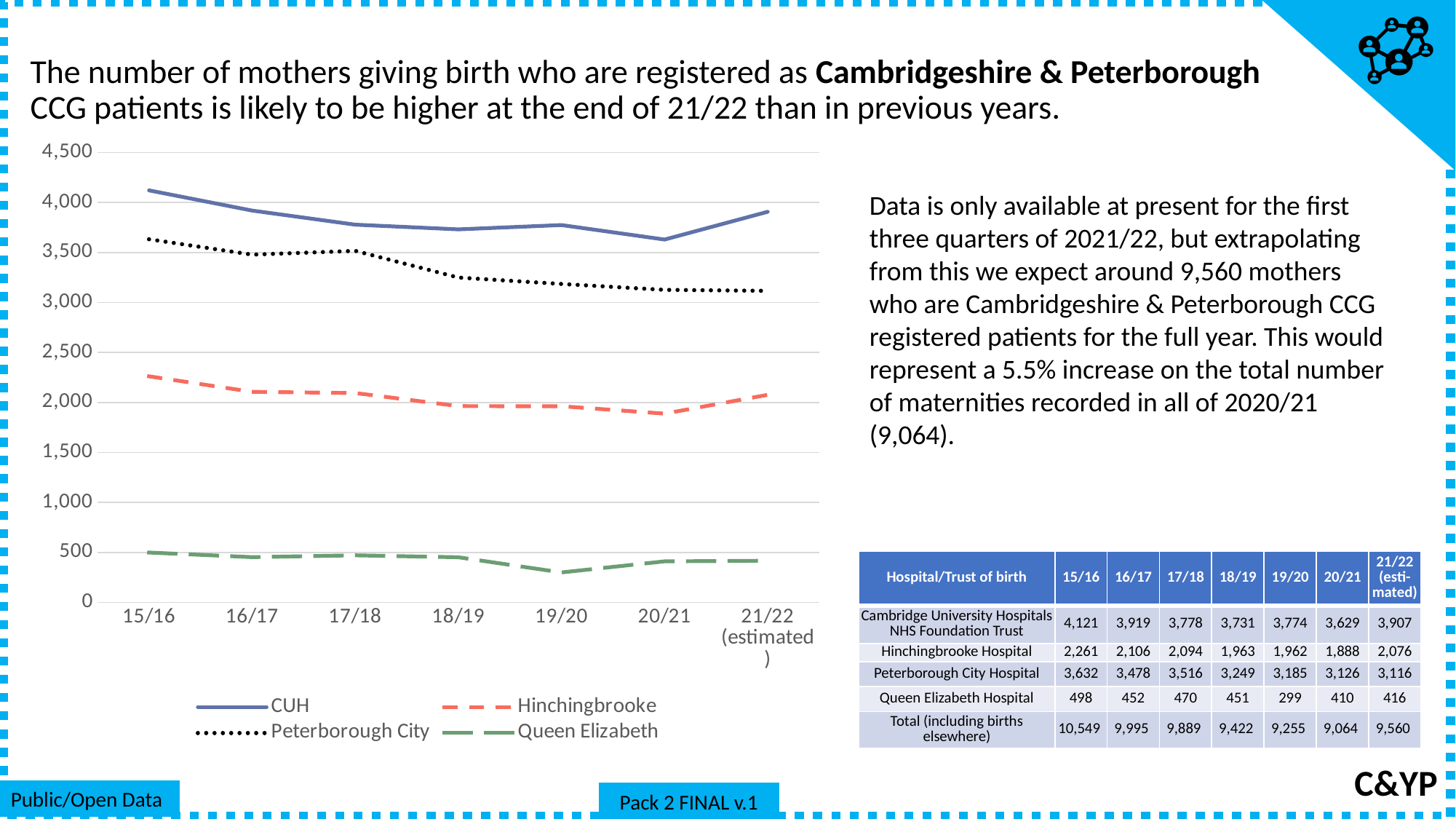
Which is larger in 17/18: the value for CUH or the value for Peterborough City? CUH How many series does the chart legend list? 4 What is the value for Queen Elizabeth in 19/20? 299 Which series has the lowest values across the chart? Queen Elizabeth Is the value for Hinchingbrooke in 19/20 greater or less than 2,000? less How many time periods are shown along the x axis of the chart? 7 Is the value for Peterborough City in 21/22 (estimated) greater or less than 3,000? greater What kind of chart is shown on the slide? line chart What is the value for CUH in 15/16? 4,121 Which series has the highest values across the chart? CUH What is the value for Hinchingbrooke in 20/21? 1,888 What is the difference between the CUH value in 15/16 and the CUH value in 20/21? 492